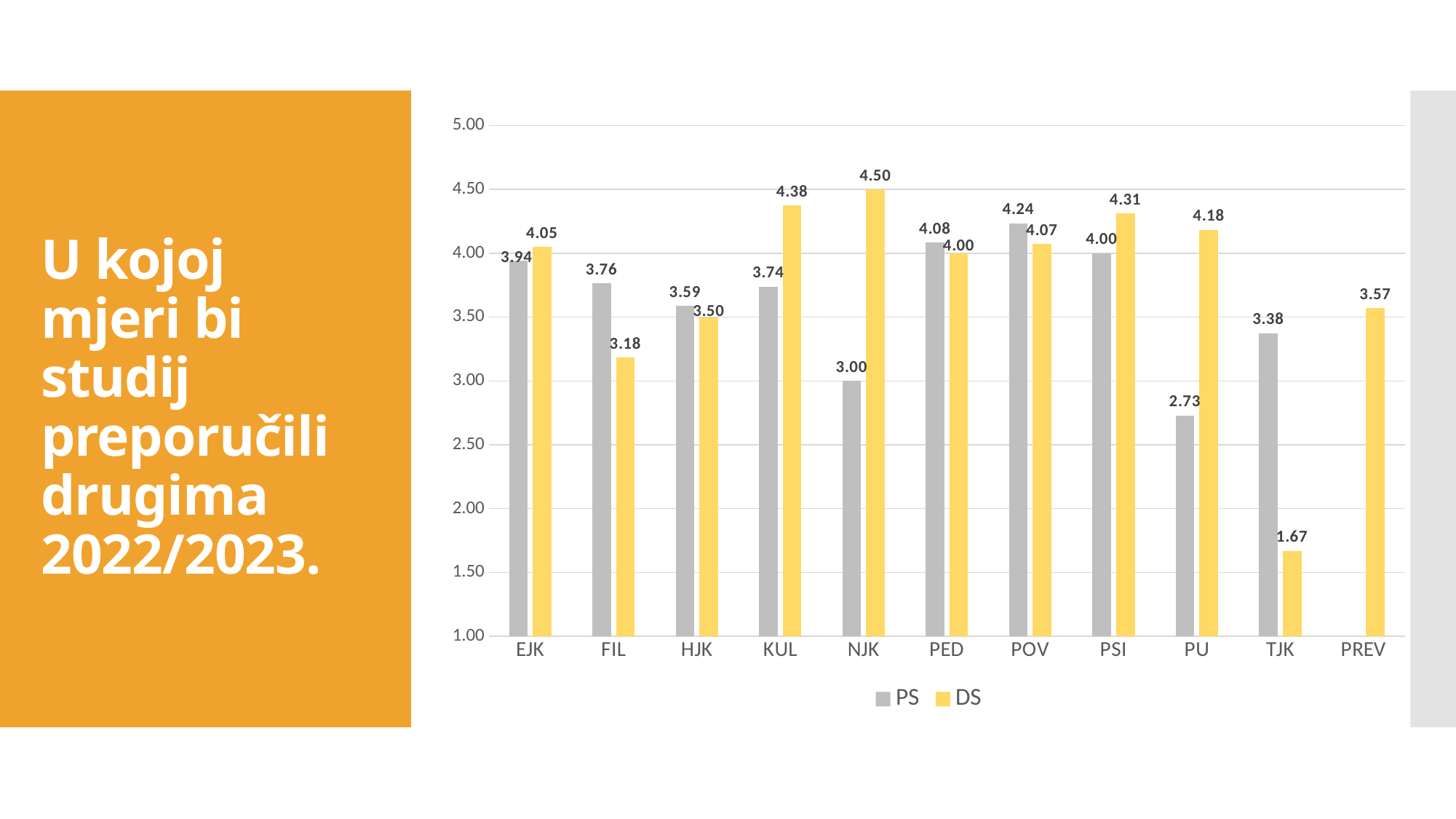
What is the difference between the DS and PS values for NJK? 1.50 Which category has the highest DS value? NJK How many categories are shown on the x axis? 11 Which category has the lowest DS value? TJK Which category has the lowest PS value? PU What is the DS value for PREV? 3.57 For FIL, which is larger, the PS value or the DS value? PS What is the difference between the PS and DS values for TJK? 1.71 What type of chart is shown on the slide? Bar chart What is the PS value for KUL? 3.74 What is the DS value for PU? 4.18 How many series does the legend list? 2